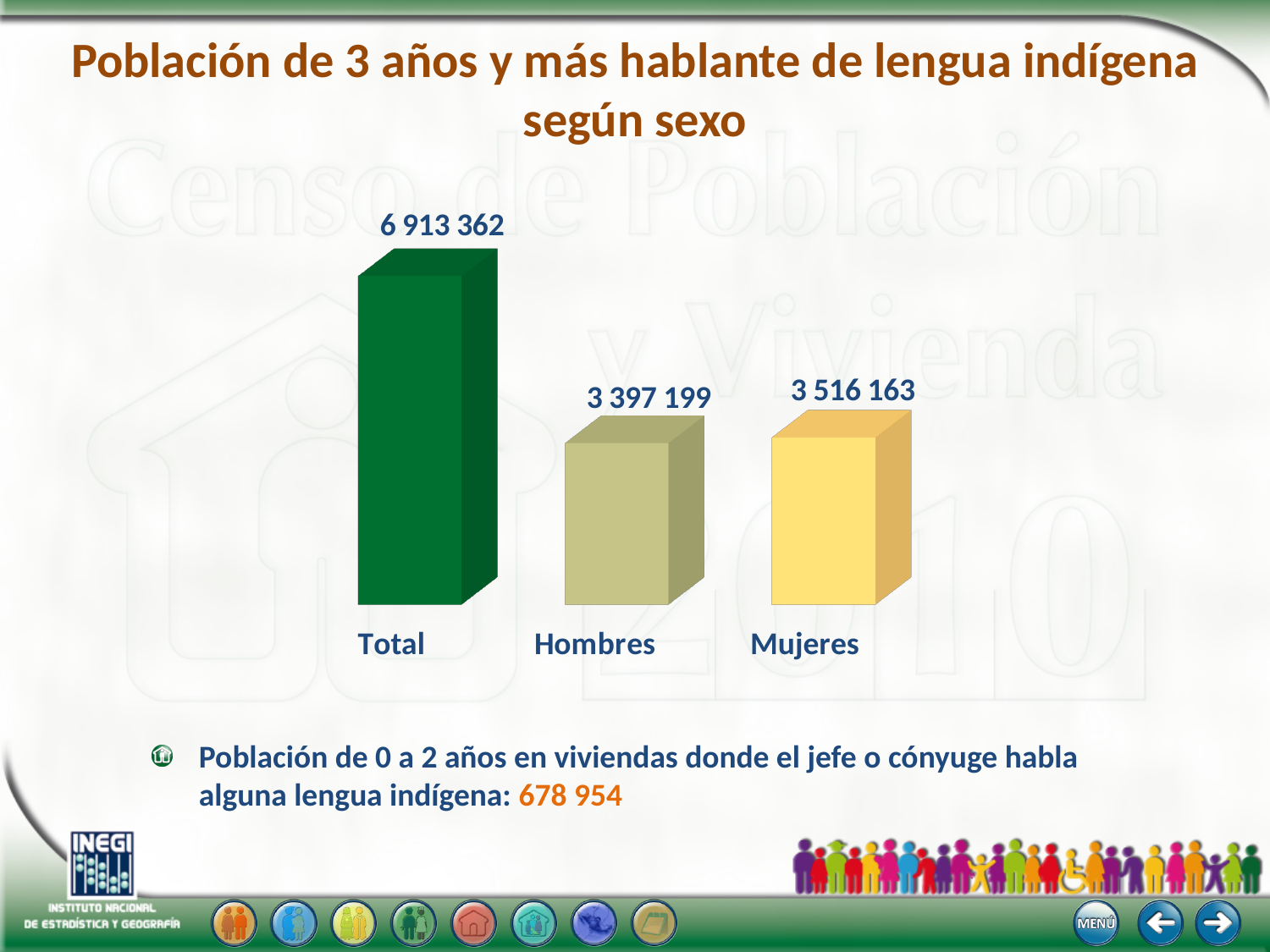
Which category has the lowest value? Hombres How many categories are shown in the chart? 3 What colour is the bar for Total? Green Which category has the highest value? Total What is the value for Mujeres? 3 516 163 Which is larger, the value for Hombres or the value for Mujeres? Mujeres What is the title of the chart? Población de 3 años y más hablante de lengua indígena según sexo What kind of chart is shown on the slide? Bar chart What is the value for Hombres? 3 397 199 What is the difference between the values for Total and Hombres? 3 516 163 What is the value for Total? 6 913 362 What is the difference between the values for Mujeres and Hombres? 118 964